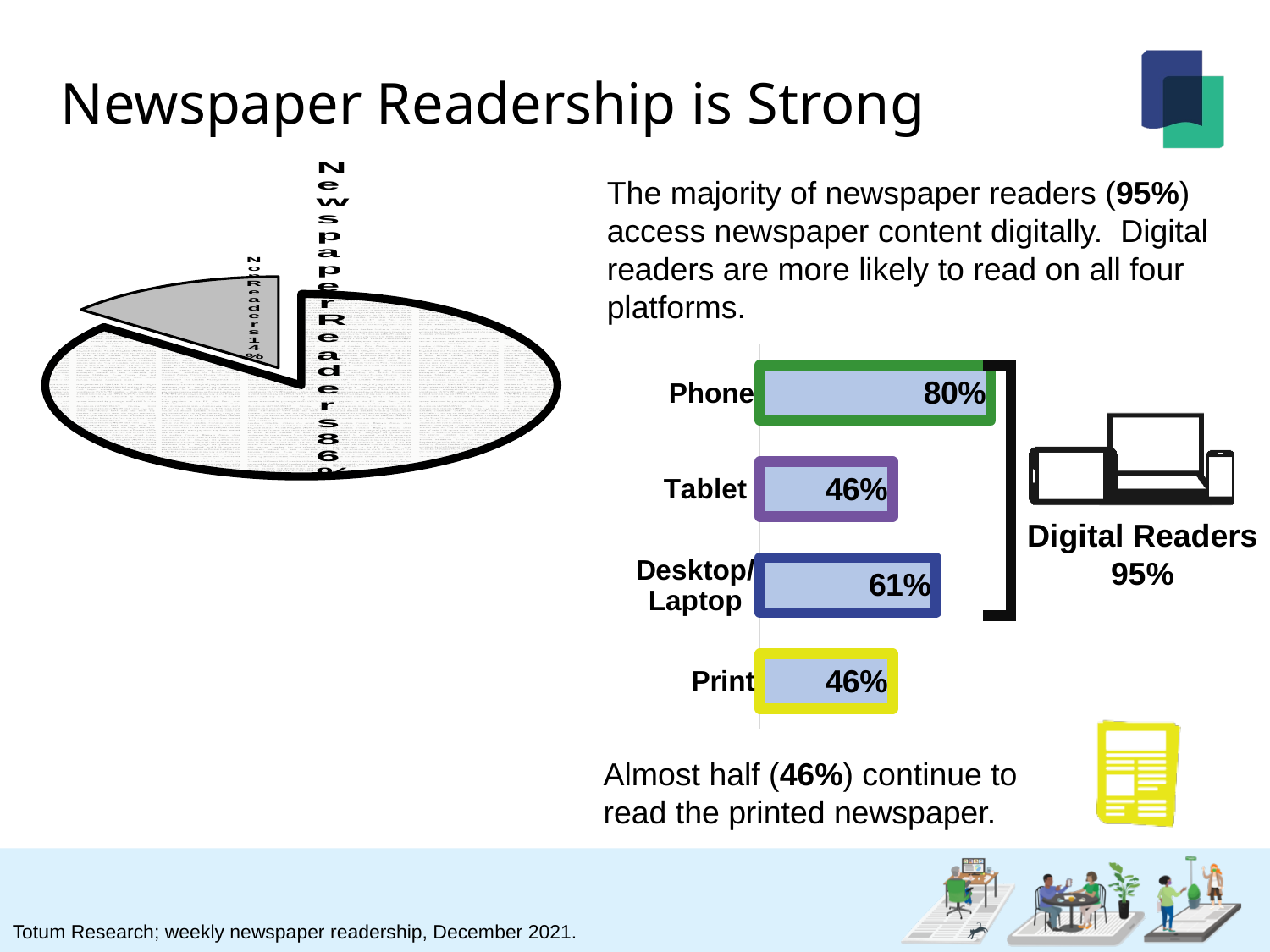
On the bar chart on the right, what is the value for Phone? 80% What kind of chart is the chart on the right side of the slide? Bar chart On the pie chart on the left, what share of the pie is Non-Readers? 14% On the bar chart on the right, what is the value for Print? 46% How many platforms are shown on the bar chart on the right? 4 On the bar chart on the right, what is the value for Tablet? 46% On the bar chart on the right, which platform has the highest value? Phone On the bar chart on the right, what is the difference between the Phone and Print values? 34% On the bar chart on the right, what is the value for Desktop/Laptop? 61% On the bar chart on the right, which is larger, the value for Desktop/Laptop or the value for Tablet? Desktop/Laptop What kind of chart is the chart on the left side of the slide? Pie chart On the bar chart on the right, what is the difference between the Phone and Desktop/Laptop values? 19%